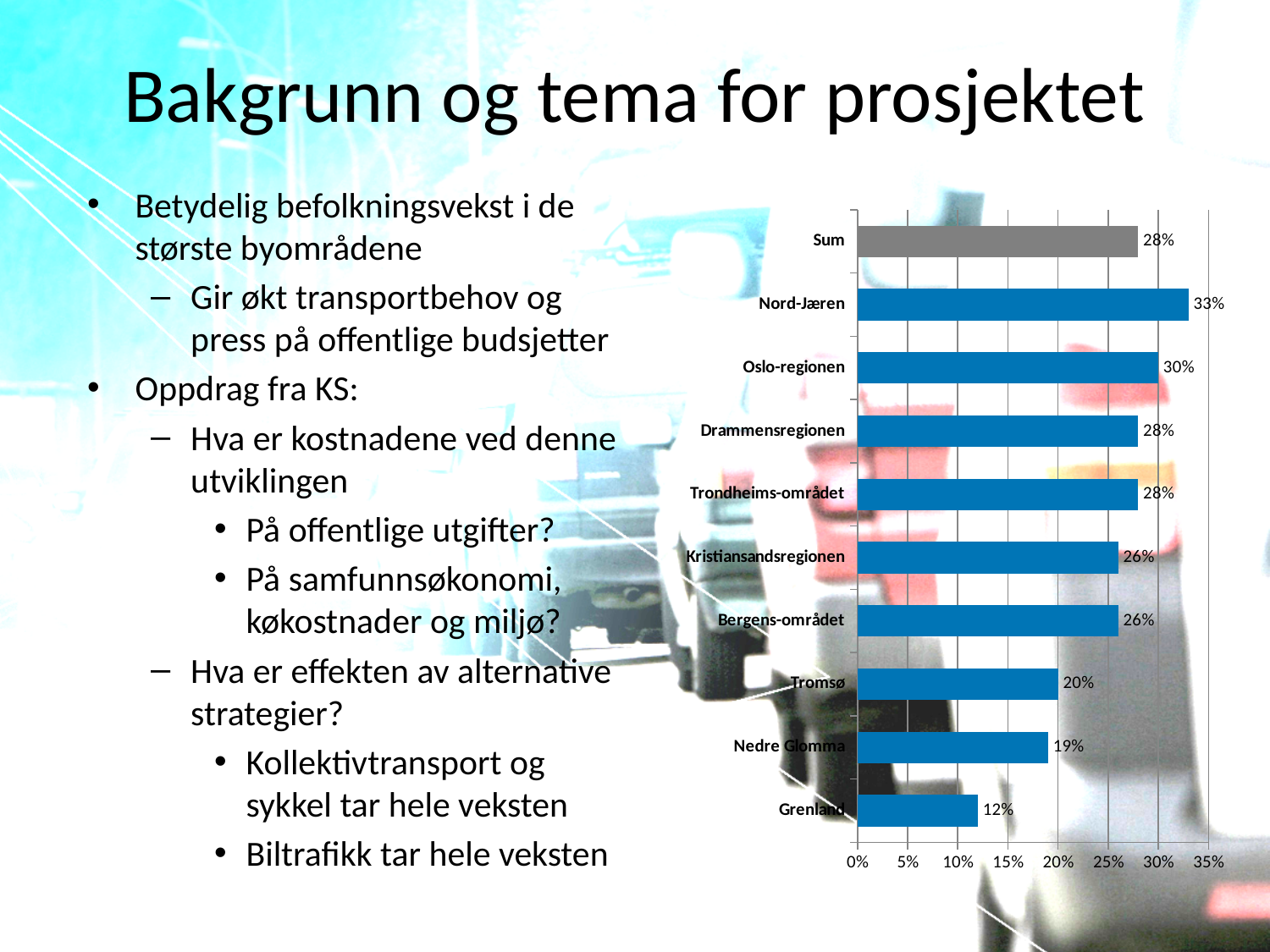
What is the value for Grenland? 12% What is the difference between the values for Nord-Jæren and Grenland? 21% Which is larger, the value for Tromsø or the value for Nedre Glomma? Tromsø Which region has the highest value? Nord-Jæren What is the value for Oslo-regionen? 30% How many bars are shown in the chart? 10 Which region has the lowest value? Grenland What is the value for Nord-Jæren? 33% What kind of chart is shown on the slide? Bar chart Which bar is coloured grey rather than blue? Sum What is the value for the Sum bar? 28% What is the difference between the values for Oslo-regionen and Tromsø? 10%